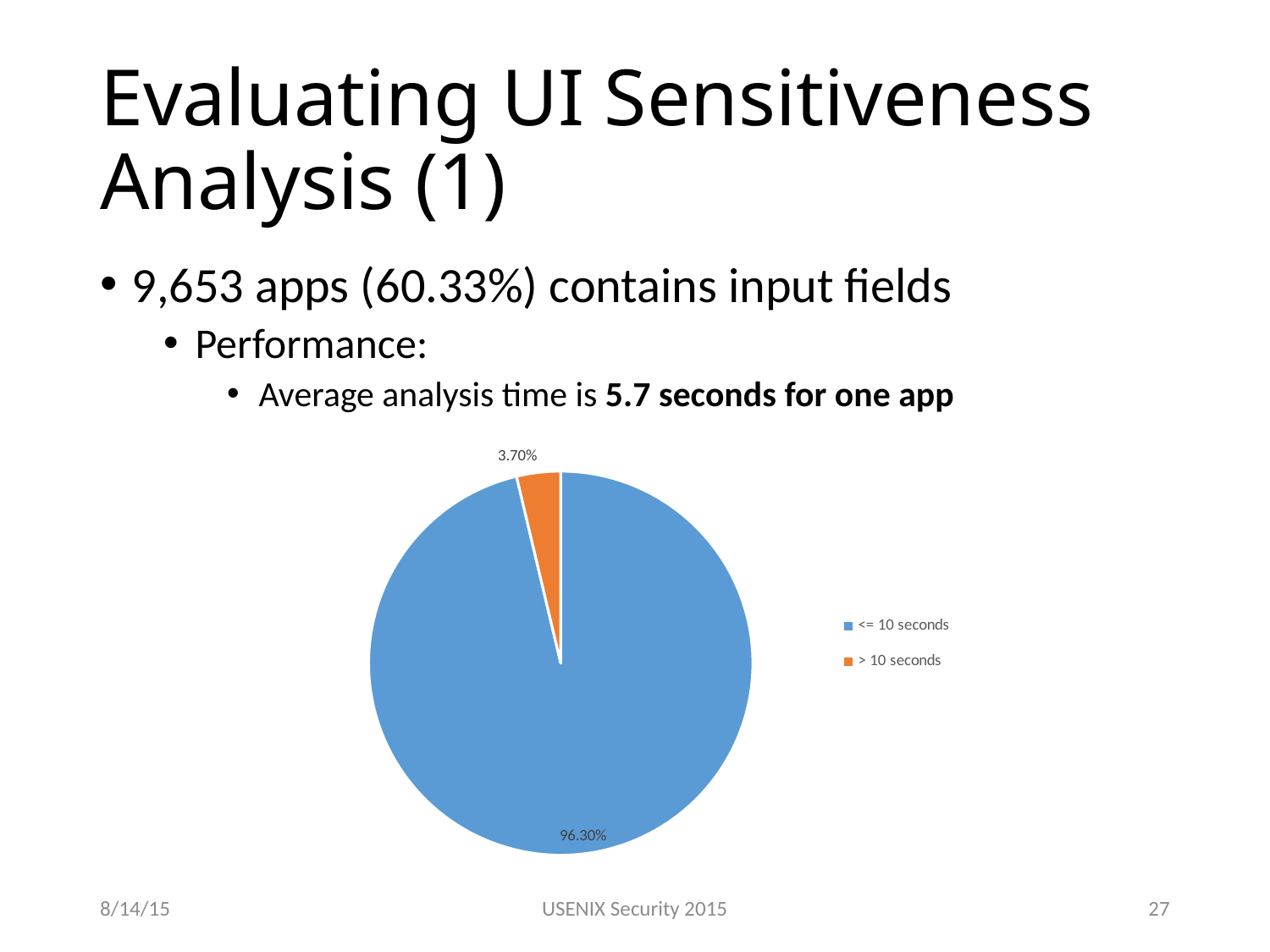
What colour is the "<= 10 seconds" slice? blue How many entries does the legend list? 2 How many slices does the pie chart have? 2 Which slice of the pie is the largest? <= 10 seconds What share of the pie does the "> 10 seconds" slice represent? 3.70% Which slice of the pie is the smallest? > 10 seconds What colour is the "> 10 seconds" slice? orange Which is larger, the "<= 10 seconds" slice or the "> 10 seconds" slice? <= 10 seconds What share of the pie does the "<= 10 seconds" slice represent? 96.30% What kind of chart is shown on the slide? pie chart What is the difference in percentage points between the "<= 10 seconds" and "> 10 seconds" slices? 92.60%